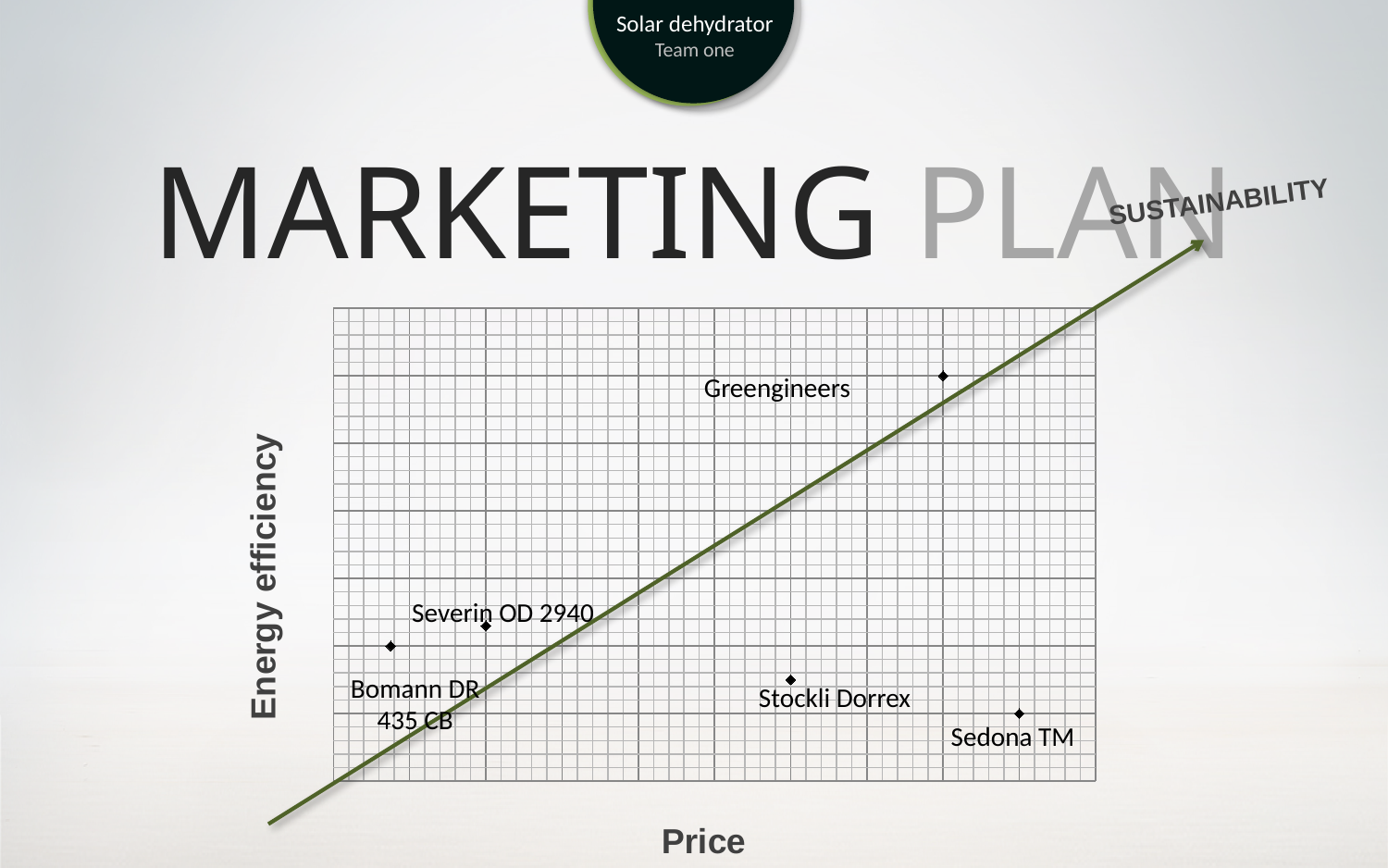
What is the label of the vertical axis of the chart? Energy efficiency Which has the higher energy efficiency, Greengineers or Stockli Dorrex? Greengineers Which product has the lowest price on the chart? Bomann DR 435 CB Which has the higher energy efficiency, Severin OD 2940 or Bomann DR 435 CB? Severin OD 2940 Which has the higher price, Severin OD 2940 or Stockli Dorrex? Stockli Dorrex What kind of chart is shown on the slide? Scatter chart Which product has the highest price on the chart? Sedona TM Which product has the highest energy efficiency on the chart? Greengineers How many products are plotted on the chart? 5 Which product has the lowest energy efficiency on the chart? Sedona TM What is the label of the horizontal axis of the chart? Price